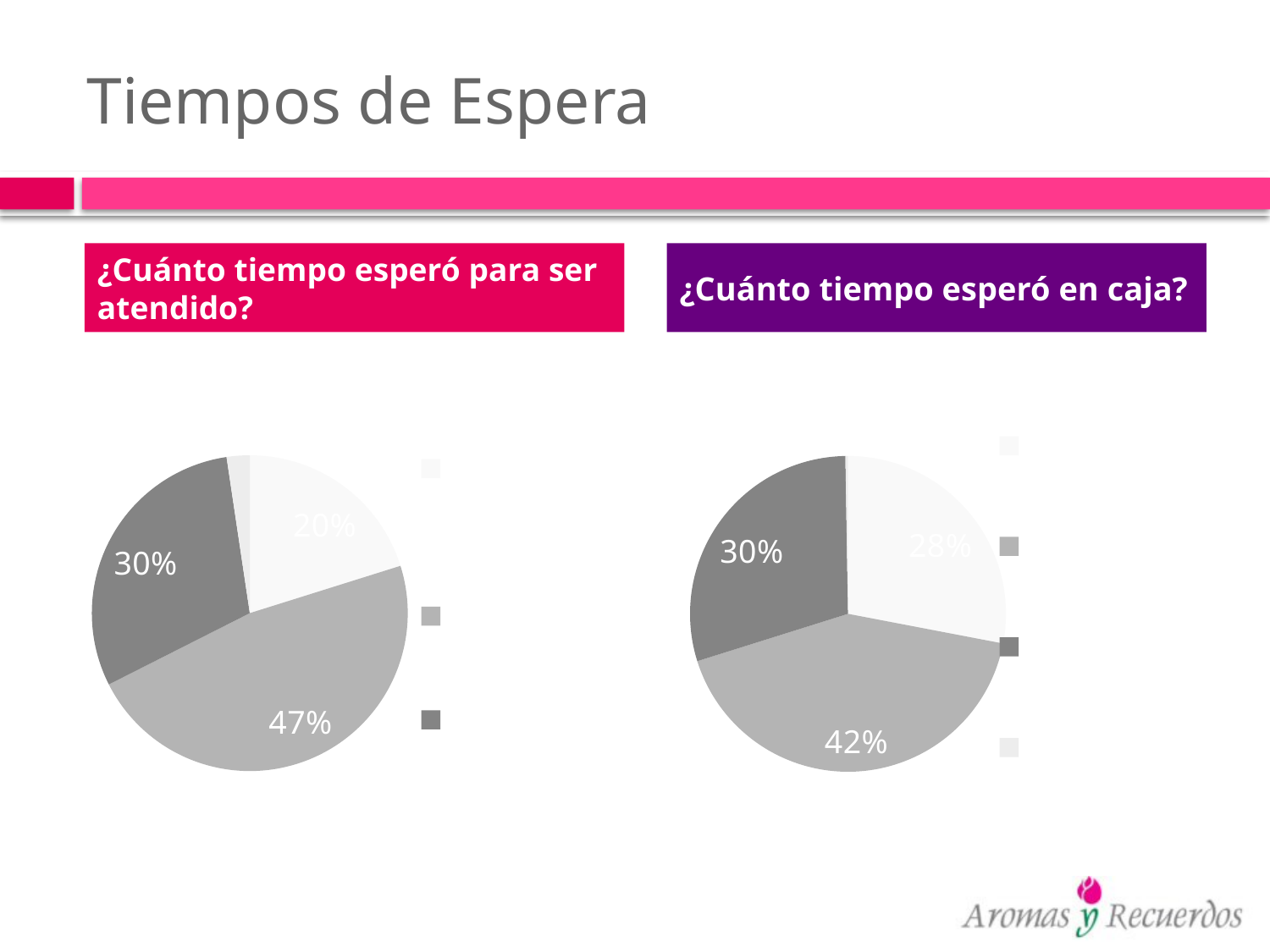
In the '¿Cuánto tiempo esperó para ser atendido?' pie chart, what value is shown on the dark grey slice? 30% In the '¿Cuánto tiempo esperó para ser atendido?' pie chart, what is the value of the largest slice? 47% How many legend markers are shown next to the '¿Cuánto tiempo esperó en caja?' pie chart? 4 What kind of chart is used under '¿Cuánto tiempo esperó para ser atendido?'? pie chart In the '¿Cuánto tiempo esperó en caja?' pie chart, what is the value of the largest slice? 42% What is the title of the slide containing the two pie charts? Tiempos de Espera In the '¿Cuánto tiempo esperó para ser atendido?' pie chart, what is the difference between the 47% slice and the 30% slice? 17 percentage points In the '¿Cuánto tiempo esperó en caja?' pie chart, what value is shown on the white slice? 28% What kind of chart is used under '¿Cuánto tiempo esperó en caja?'? pie chart Which is larger: the largest slice of the '¿Cuánto tiempo esperó para ser atendido?' pie or the largest slice of the '¿Cuánto tiempo esperó en caja?' pie? the '¿Cuánto tiempo esperó para ser atendido?' pie (47%)